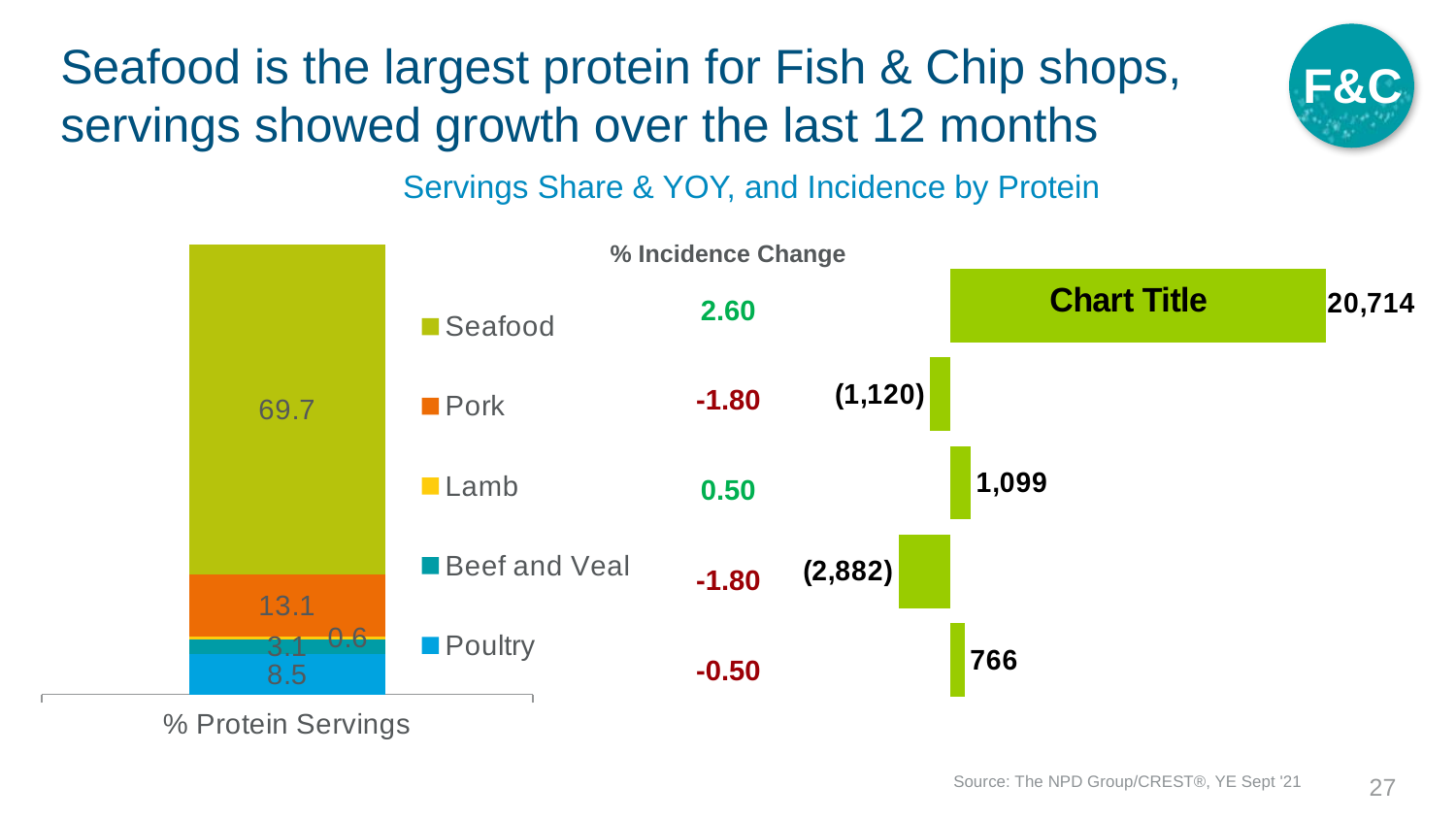
In the % Protein Servings stacked bar chart, which protein has the largest share? Seafood In the % Protein Servings stacked bar chart, which protein has the smallest share? Lamb In the bar chart on the right labelled Chart Title, what is the value for Beef and Veal? (2,882) In the bar chart on the right labelled Chart Title, what is the value for Seafood? 20,714 In the % Incidence Change column, what is the value for Lamb? 0.50 In the % Protein Servings stacked bar chart, what is the value for Pork? 13.1 In the % Protein Servings stacked bar chart, what is the difference between the Seafood and Pork values? 56.6 In the % Protein Servings stacked bar chart, what is the value for Poultry? 8.5 In the % Protein Servings stacked bar chart, what is the value for Seafood? 69.7 What kind of chart is the % Protein Servings chart? Stacked bar chart How many series does the legend of the % Protein Servings chart list? 5 In the % Incidence Change column, what is the value for Seafood? 2.60